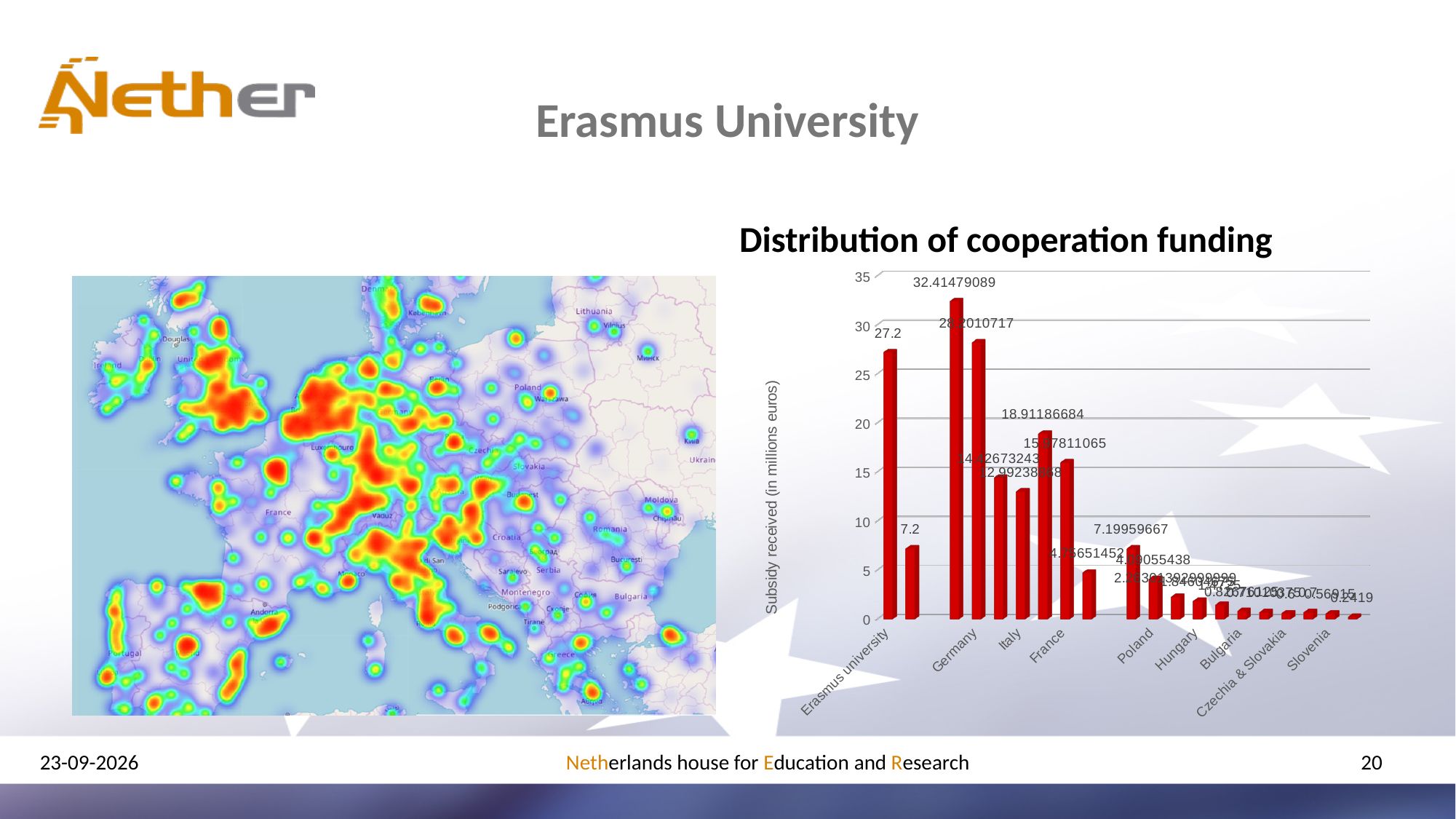
In the 'Distribution of cooperation funding' chart, is the value for Erasmus university greater or less than 30? less In the 'Distribution of cooperation funding' chart, what is the highest tick value shown on the vertical axis? 35 What kind of chart is 'Distribution of cooperation funding'? bar chart In the 'Distribution of cooperation funding' chart, is the value for Erasmus university greater or less than 25? greater In the 'Distribution of cooperation funding' chart, what is the value for Erasmus university? 27.2 In the 'Distribution of cooperation funding' chart, what is the difference between the highest bar value (32.41479089) and the Erasmus university value (27.2)? 5.21479089 What is the title of the bar chart on the slide? Distribution of cooperation funding In the 'Distribution of cooperation funding' chart, what is the lowest value labelled on any bar? 0.2419 In the 'Distribution of cooperation funding' chart, what is the highest value labelled on any bar? 32.41479089 What is the vertical axis title of the 'Distribution of cooperation funding' chart? Subsidy received (in millions euros)